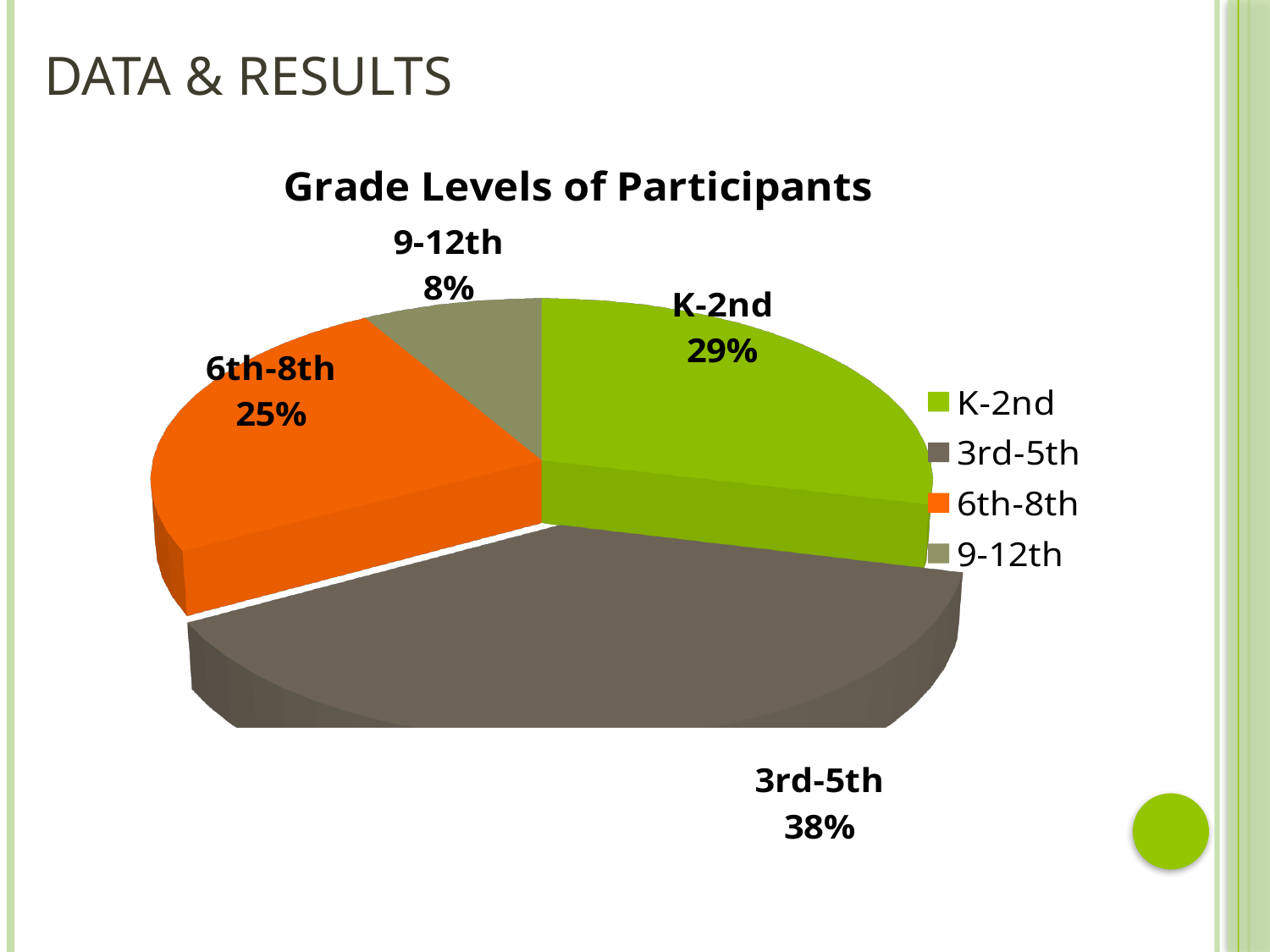
What share of participants are in grades K-2nd? 29% What is the difference in percentage points between the 3rd-5th and K-2nd shares? 9% How many grade-level categories does the pie chart show? 4 Which has a larger share of participants, K-2nd or 6th-8th? K-2nd What share of participants are in grades 3rd-5th? 38% Which grade level has the largest share of participants? 3rd-5th Which grade level has the smallest share of participants? 9-12th What is the title of the chart? Grade Levels of Participants What share of participants are in grades 9-12th? 8% What kind of chart is shown on the slide? Pie chart What colour is the slice for 6th-8th? Orange